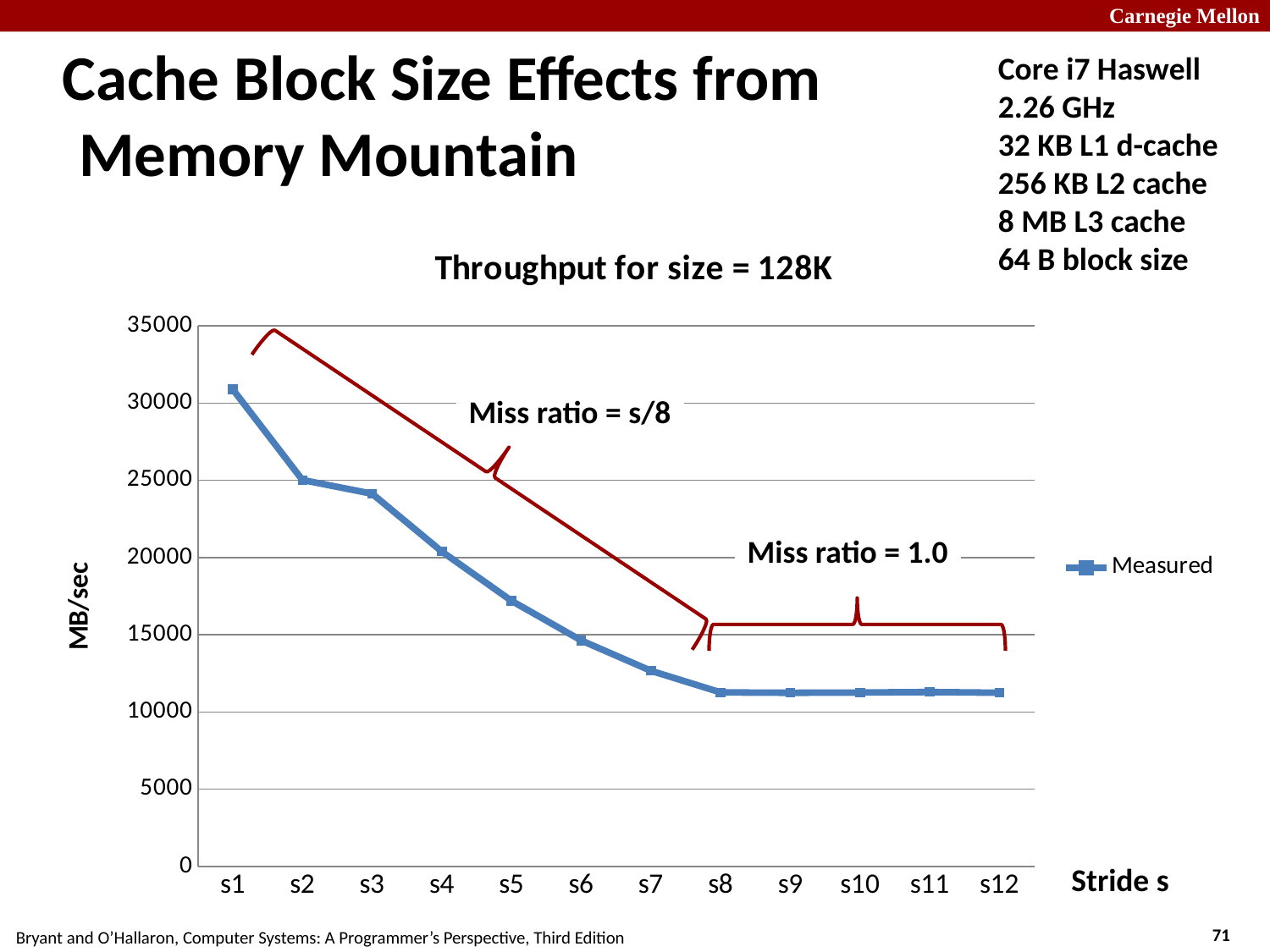
Which has the larger measured throughput, s1 or s7? s1 Is the measured throughput for s7 greater or less than 10000? greater What is the label of the y axis? MB/sec Is the measured throughput for s3 greater or less than 25000? less Is the measured throughput for s1 greater or less than 30000? greater How many series does the legend list? 1 How many stride values (data points) are plotted on the x axis? 12 Which stride has the highest measured throughput? s1 Does the measured throughput rise or fall as the stride increases from s1 to s8? fall What kind of chart is shown on the slide? line chart What is the title of the chart? Throughput for size = 128K